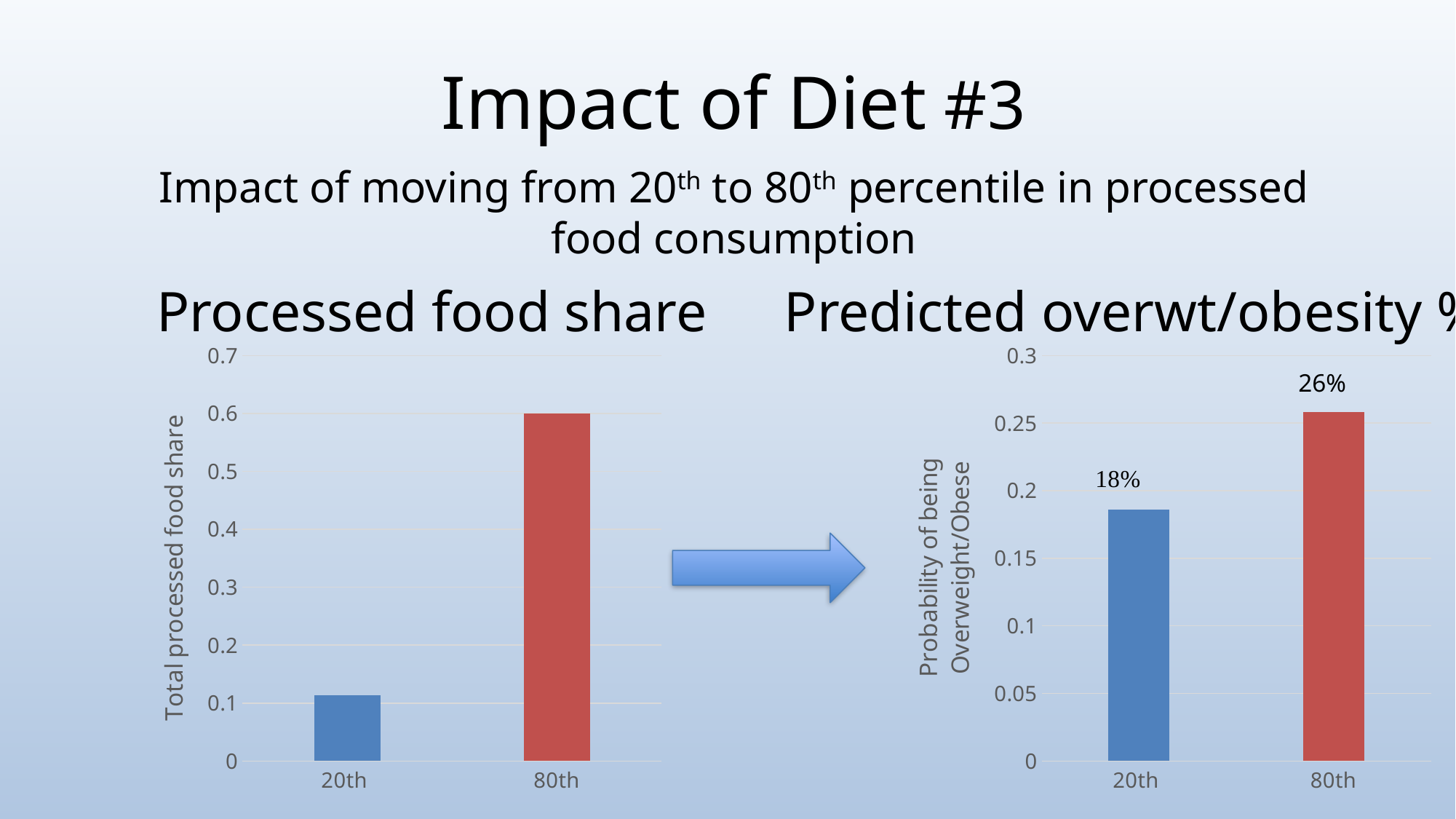
What is the y-axis label of the Predicted overwt/obesity % chart? Probability of being Overweight/Obese On the Predicted overwt/obesity % chart, what is the difference between the 80th and 20th percentile values? 8% On the Processed food share chart, is the value for the 80th percentile greater or less than 0.5? greater On the Processed food share chart, is the value for the 80th percentile larger than the value for the 20th percentile? Yes On the Processed food share chart, which percentile has the lower value? 20th On the Processed food share chart, is the value for the 20th percentile greater or less than 0.2? less On the Predicted overwt/obesity % chart, what is the value for the 80th percentile? 26% What is the y-axis label of the Processed food share chart? Total processed food share What kind of chart is the Predicted overwt/obesity % chart? Bar chart How many categories are shown on the Processed food share chart? 2 On the Predicted overwt/obesity % chart, what is the value for the 20th percentile? 18% On the Predicted overwt/obesity % chart, which percentile has the higher value? 80th